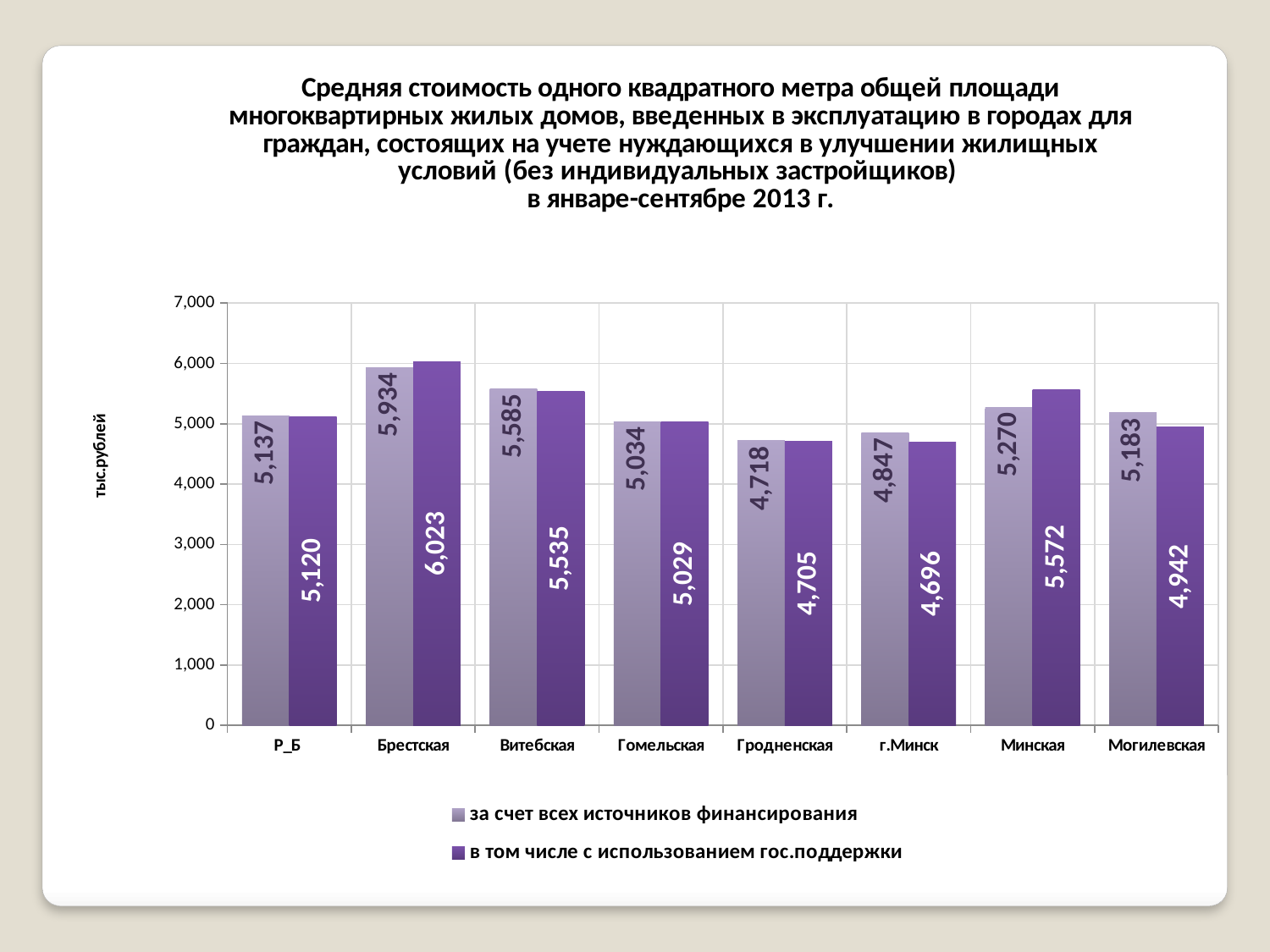
What is the value for Брестская in the series 'за счет всех источников финансирования'? 5,934 How many series does the legend list? 2 What is the difference between the two series values for Могилевская? 241 What is the value for Минская in the series 'в том числе с использованием гос.поддержки'? 5,572 Which category has the lowest value in the series 'за счет всех источников финансирования'? Гродненская How many categories are shown on the x axis? 8 Which category has the highest value in the series 'в том числе с использованием гос.поддержки'? Брестская What is the value for г.Минск in the series 'за счет всех источников финансирования'? 4,847 Which is larger for Минская: the value for 'за счет всех источников финансирования' or 'в том числе с использованием гос.поддержки'? в том числе с использованием гос.поддержки Is the value for Гродненская in the series 'в том числе с использованием гос.поддержки' greater or less than 5,000? less What is the unit label on the vertical axis? тыс.рублей What kind of chart is shown on the slide? bar chart